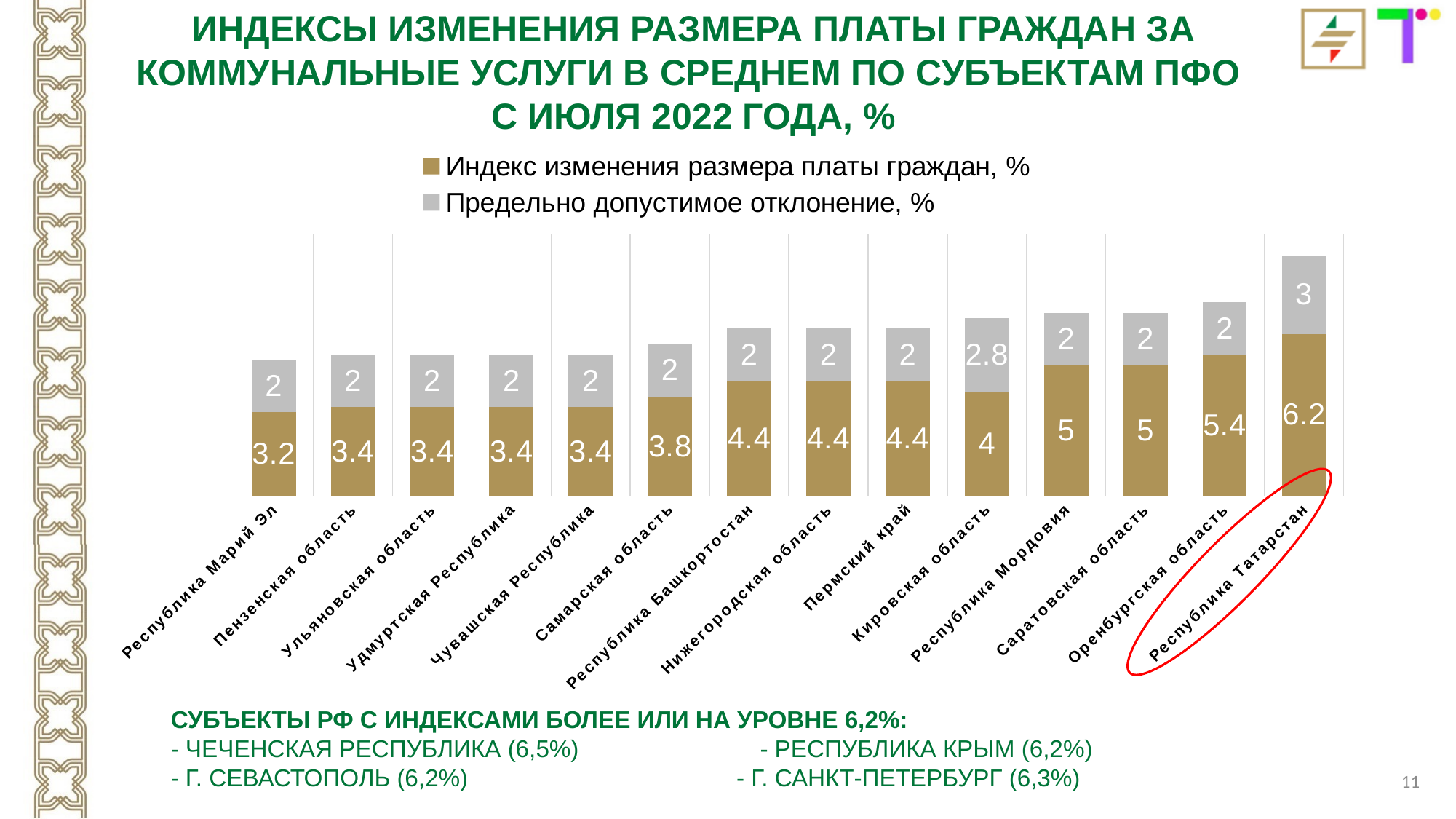
What kind of chart is shown on the slide? Stacked bar chart Which region has the lowest 'Индекс изменения размера платы граждан, %'? Республика Марий Эл What is the value of 'Индекс изменения размера платы граждан, %' for Самарская область? 3.8 What is the difference between the 'Индекс изменения размера платы граждан, %' for Республика Татарстан and Оренбургская область? 0.8 What is the value of 'Индекс изменения размера платы граждан, %' for Республика Татарстан? 6.2 What is the total height of the stacked bar for Кировская область? 6.8 What is the total height of the stacked bar for Республика Татарстан? 9.2 Which has a larger 'Индекс изменения размера платы граждан, %': Республика Мордовия or Пермский край? Республика Мордовия How many series does the legend list? 2 Which region has the highest 'Индекс изменения размера платы граждан, %'? Республика Татарстан What is the value of 'Предельно допустимое отклонение, %' for Кировская область? 2.8 How many regions are shown on the x axis of the chart? 14